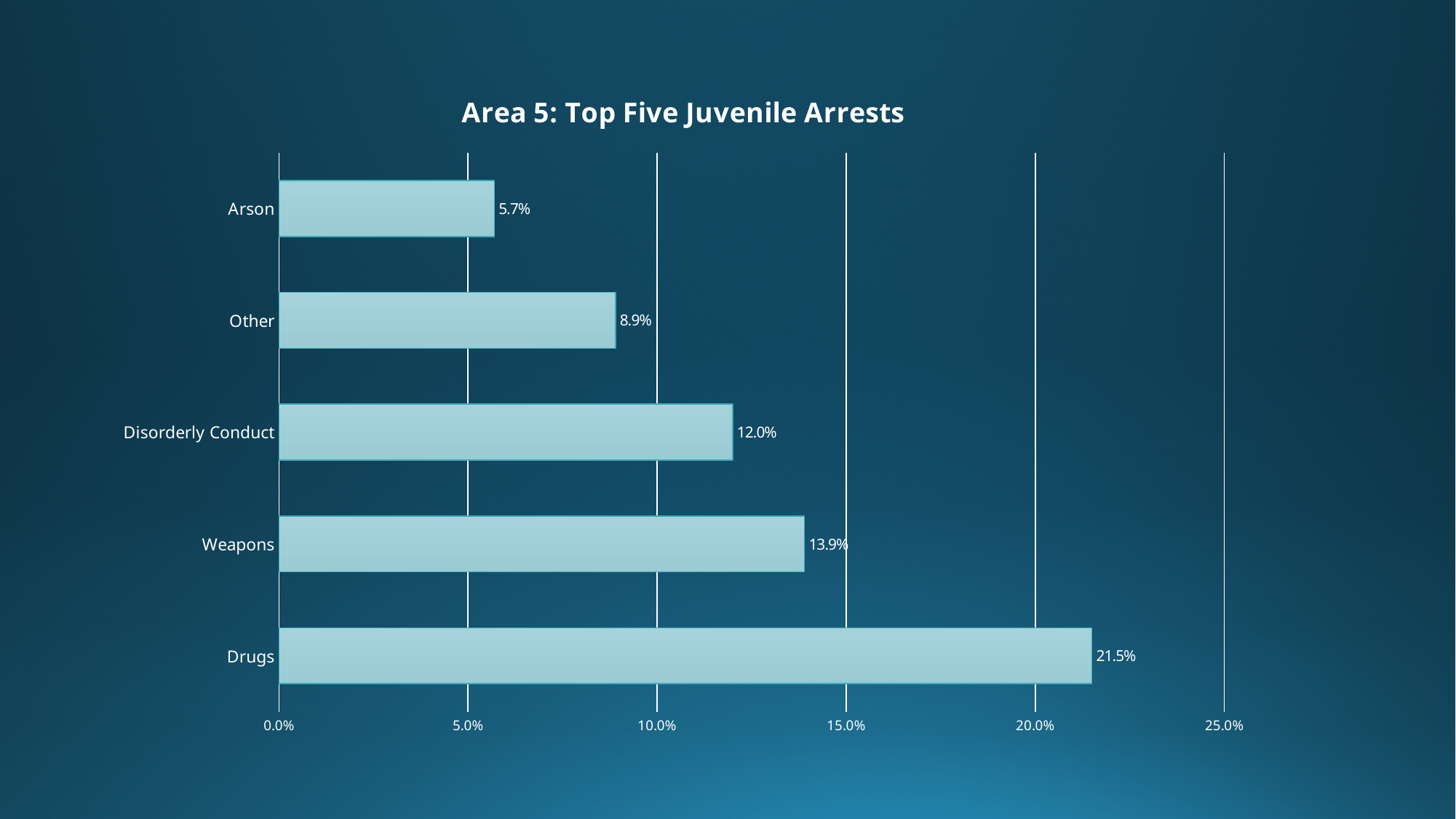
What is the difference between the values for Other and Arson? 3.2% What kind of chart is shown on the slide? Bar chart Which is larger, the value for Disorderly Conduct or the value for Other? Disorderly Conduct How many categories are shown in the chart? 5 What is the value for Weapons? 13.9% What is the value for Arson? 5.7% Is the value for Weapons greater or less than 15.0%? less Which category has the lowest value? Arson Which category has the highest value? Drugs What is the value for Disorderly Conduct? 12.0% What is the value for Drugs? 21.5% What is the difference between the values for Drugs and Weapons? 7.6%